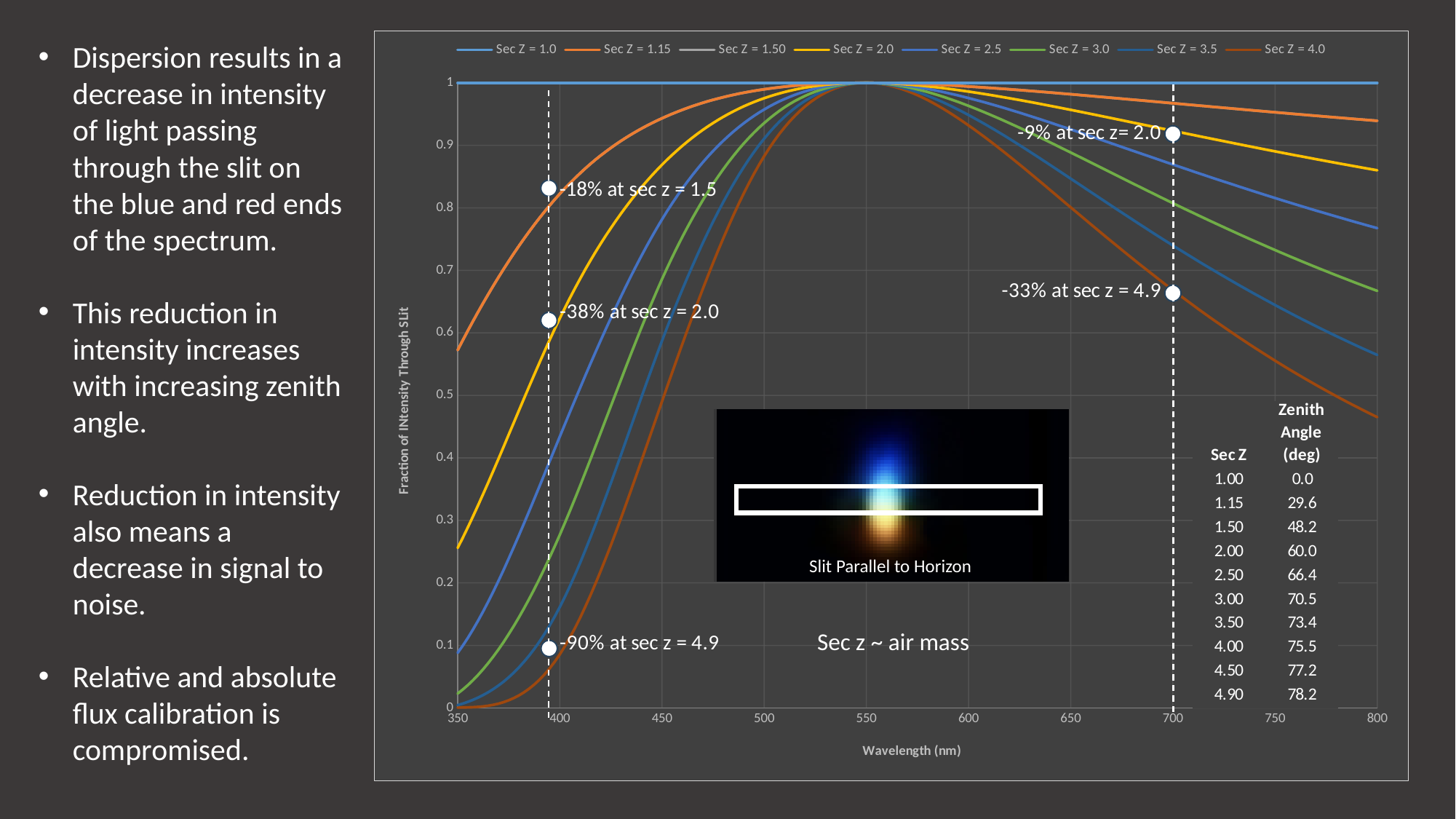
Which series has the lowest value at 800 nm? Sec Z = 4.0 What percentage reduction is annotated at sec z = 1.5 near 400 nm? -18% What kind of chart is shown on the slide? line chart What is the label of the x axis of the chart? Wavelength (nm) At 800 nm, which is larger: the Sec Z = 1.15 line or the Sec Z = 4.0 line? Sec Z = 1.15 Is the value of the Sec Z = 4.0 line at 800 nm greater or less than 0.5? less How many series does the chart legend list? 8 What is the label of the y axis of the chart? Fraction of INtensity Through SLit Does the Sec Z = 4.0 line rise or fall between 550 nm and 800 nm? fall What is the value of the Sec Z = 1.0 line at 350 nm? 1 What percentage reduction is annotated at sec z = 4.9 near 400 nm? -90% What percentage reduction is annotated at sec z = 4.9 near 700 nm? -33%